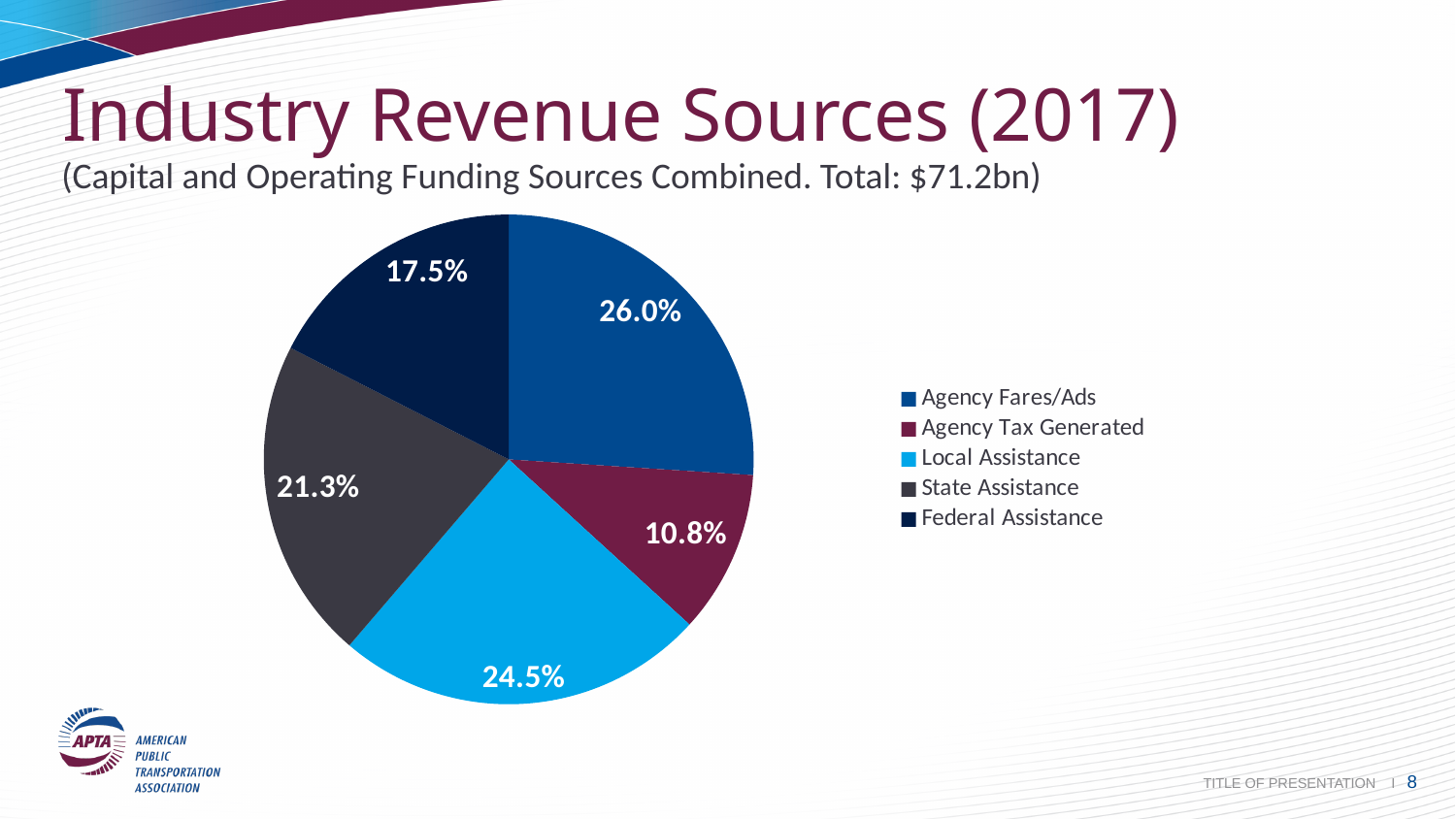
What is the difference in percentage points between Agency Fares/Ads and Agency Tax Generated? 15.2 Which revenue source has the smallest share of the pie? Agency Tax Generated How many slices does the pie chart have? 5 What share of the pie does State Assistance represent? 21.3% Which is larger, the share for State Assistance or the share for Federal Assistance? State Assistance What total dollar amount does the subtitle give for the revenue sources? $71.2bn Which revenue source has the largest share of the pie? Agency Fares/Ads What share of the pie does Agency Fares/Ads represent? 26.0% What share of the pie does Agency Tax Generated represent? 10.8% What kind of chart is shown on the slide? Pie chart